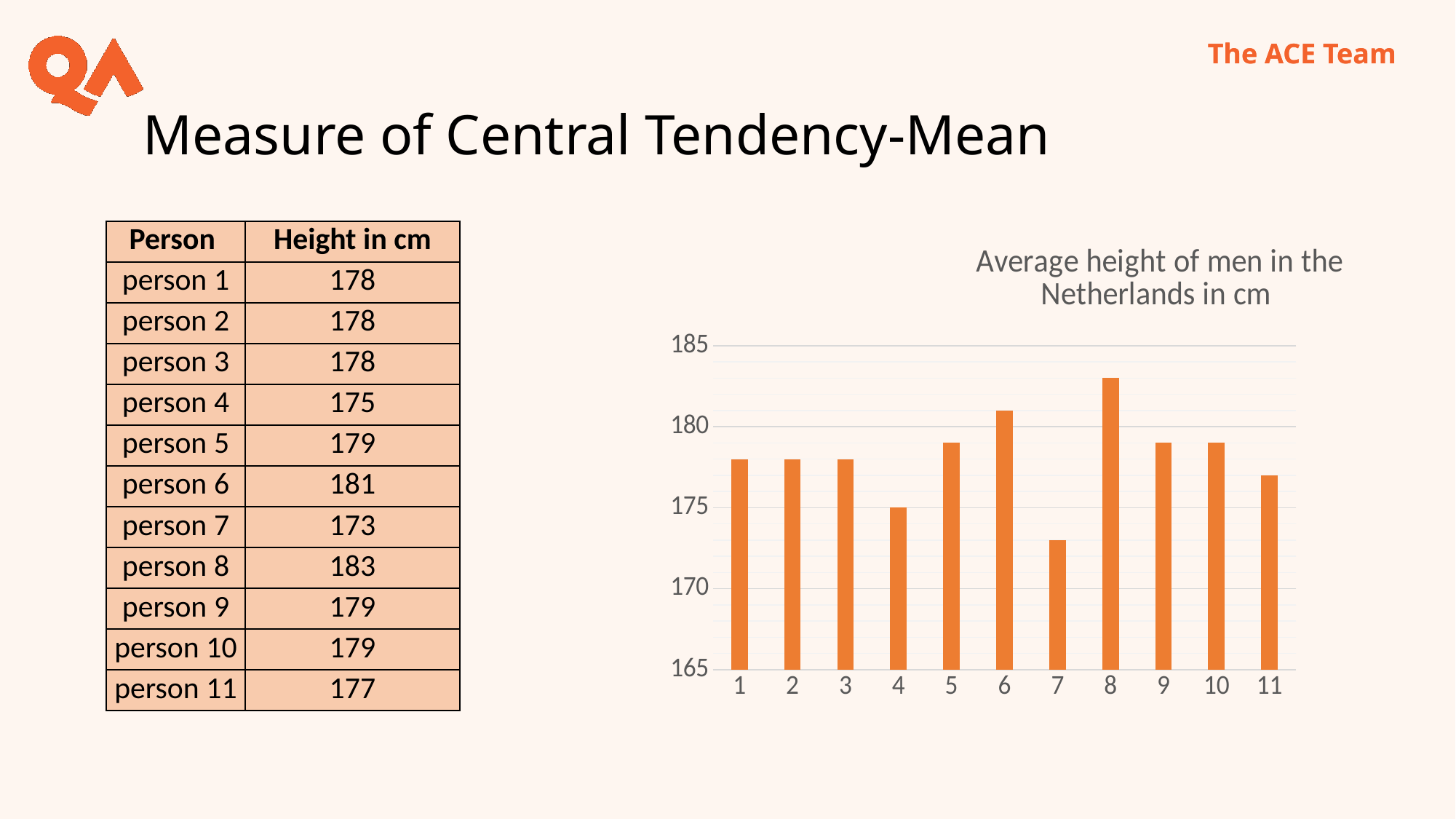
What is the difference in cm between the tallest (person 8) and shortest (person 7) heights? 10 What is the lowest value shown on the vertical axis of the chart? 165 Is the value for person 7 greater or less than 175? less How many bars (persons) are plotted in the chart? 11 What kind of chart is shown on the slide? bar chart Which person has the tallest bar in the chart? 8 What is the height in cm for person 8? 183 Which person has the shortest bar in the chart? 7 What is the height in cm for person 4? 175 Is the value for person 8 greater or less than 180? greater Which is taller, person 6 or person 5? person 6 What is the title of the chart? Average height of men in the Netherlands in cm